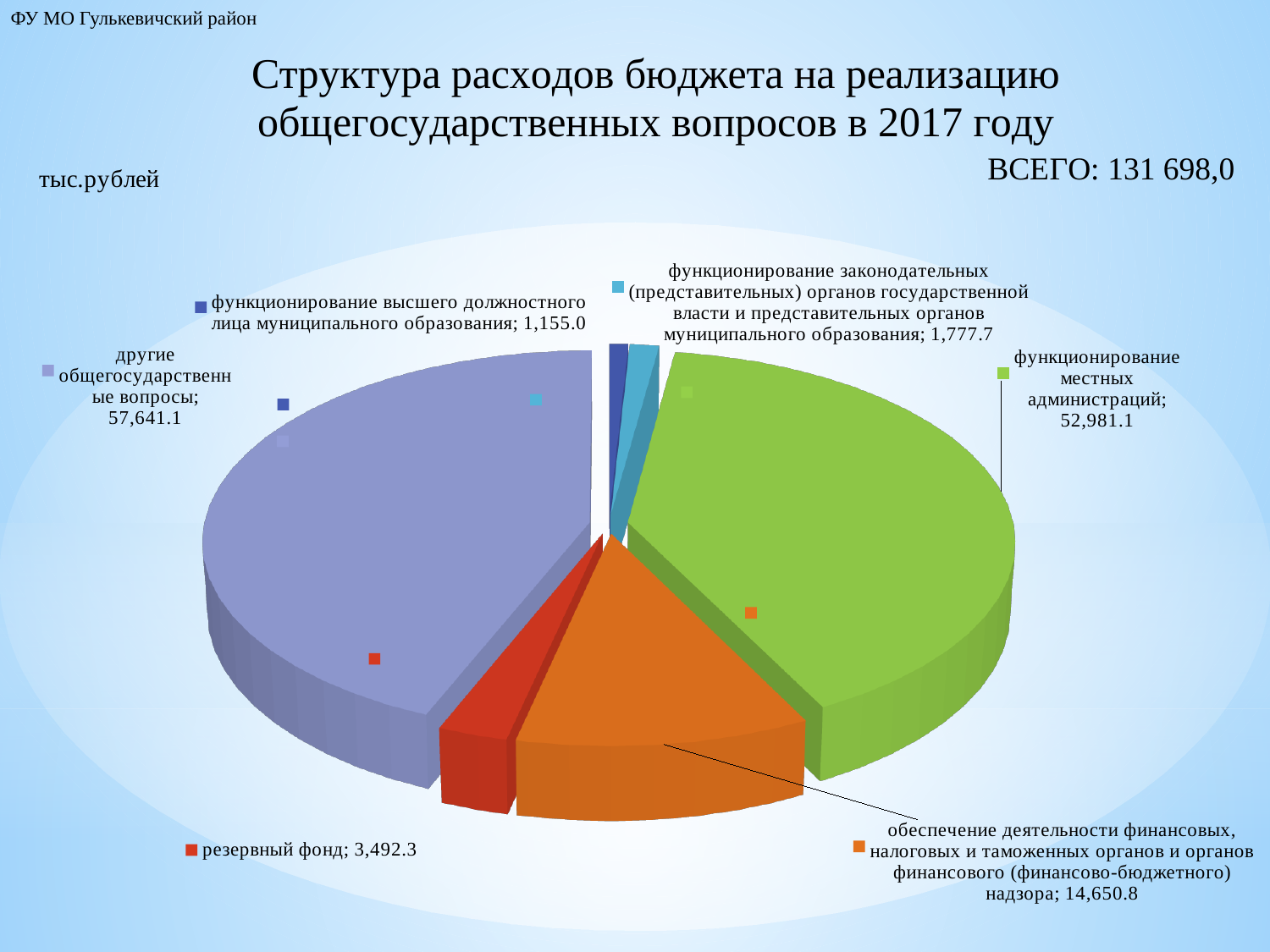
What kind of chart is shown on the slide? pie chart How many slices does the pie chart have? 6 Which category has the smallest value? функционирование высшего должностного лица муниципального образования What is the difference between "обеспечение деятельности финансовых, налоговых и таможенных органов..." and "резервный фонд"? 11,158.5 Which is larger: "функционирование законодательных (представительных) органов..." or "функционирование высшего должностного лица муниципального образования"? функционирование законодательных (представительных) органов What is the value for "другие общегосударственные вопросы"? 57,641.1 What is the value for "обеспечение деятельности финансовых, налоговых и таможенных органов и органов финансового (финансово-бюджетного) надзора"? 14,650.8 What is the value for "функционирование высшего должностного лица муниципального образования"? 1,155.0 What is the difference between "другие общегосударственные вопросы" and "функционирование местных администраций"? 4,660.0 Which category has the largest value? другие общегосударственные вопросы What is the value for "функционирование местных администраций"? 52,981.1 What is the value for "резервный фонд"? 3,492.3